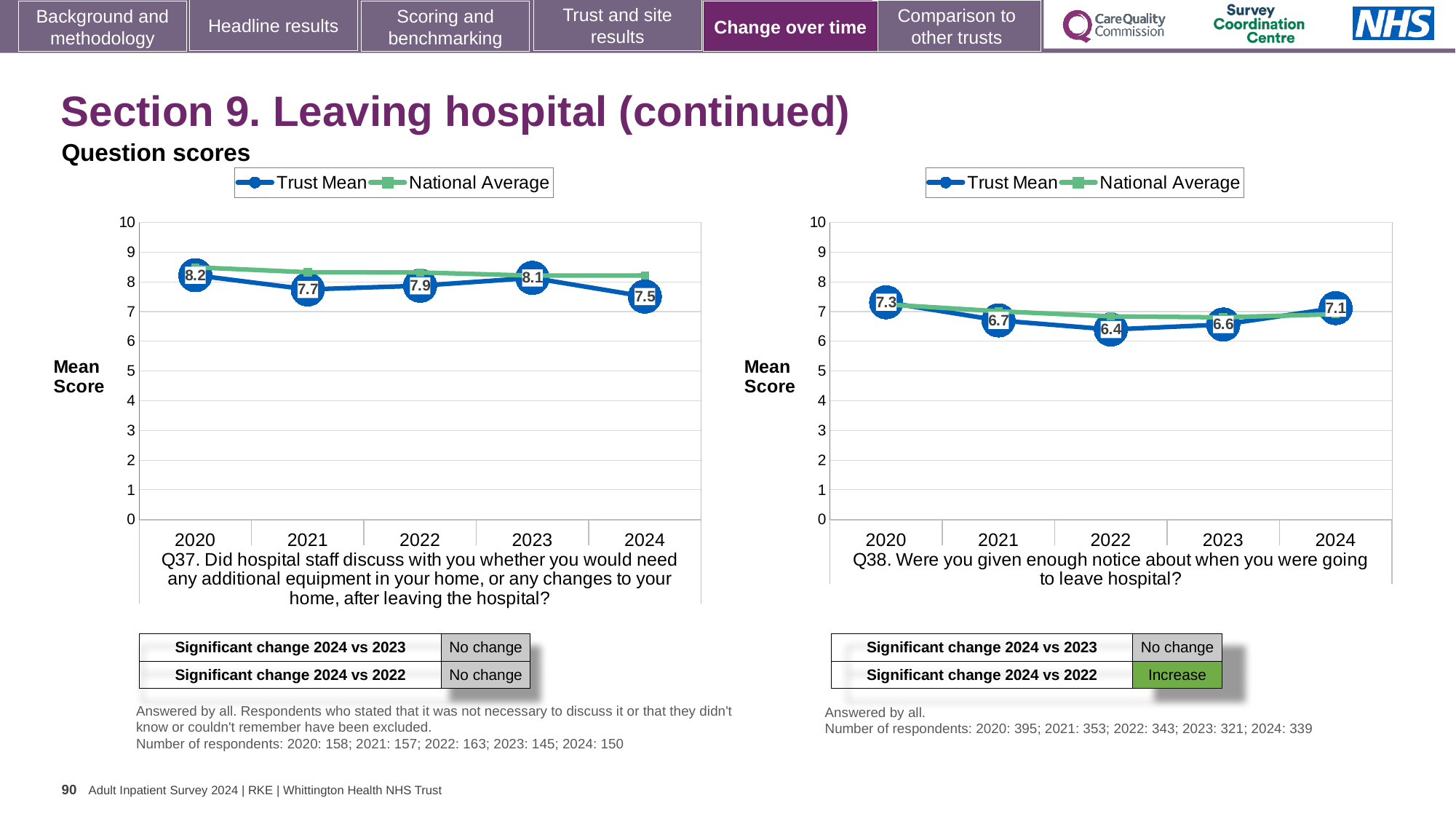
In the Q37 chart on the left, what is the Trust Mean score for 2024? 7.5 What kind of chart is the Q38 chart on the right? Line chart How many years are plotted on the x axis of the Q38 chart on the right? 5 In the Q38 chart on the right, what is the Trust Mean score for 2022? 6.4 In the Q37 chart on the left, what is the difference between the Trust Mean scores for 2020 and 2024? 0.7 In the Q38 chart on the right, which year has the lowest Trust Mean score? 2022 In the Q38 chart on the right, does the Trust Mean score rise or fall from 2022 to 2024? Rise In the Q38 chart on the right, which year has the larger Trust Mean score, 2020 or 2024? 2020 In the Q37 chart on the left, which year has the highest Trust Mean score? 2020 How many series does the legend of the Q37 chart on the left list? 2 In the Q37 chart on the left, is the National Average value for 2020 greater or less than 8? greater In the Q38 chart on the right, what is the difference between the Trust Mean scores for 2024 and 2022? 0.7